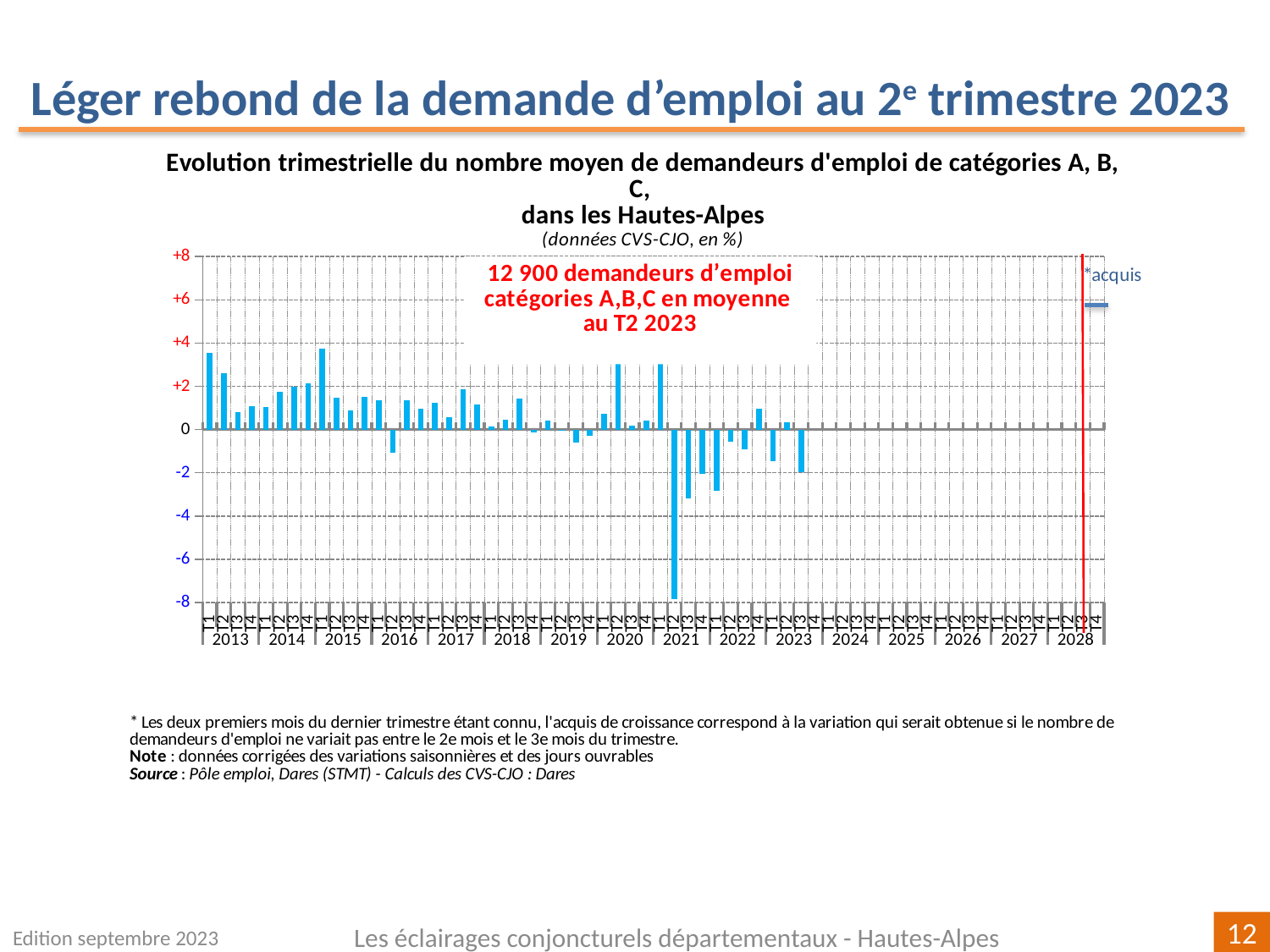
How many year labels appear along the x axis of the chart? 16 Is the value for T2 2020 greater or less than +2? greater Which is lower, the value for T2 2021 or the value for T3 2021? T2 2021 In which département does the chart measure the evolution of demandeurs d'emploi? Hautes-Alpes Which is higher, the value for T1 2013 or the value for T2 2013? T1 2013 Is the value for T2 2021 greater or less than -6? less Is the value for T3 2021 greater or less than -2? less What kind of chart is shown on the slide? Bar chart Which quarter has the lowest value on the chart? T2 2021 According to the text box on the chart, how many demandeurs d'emploi catégories A,B,C were there on average in T2 2023? 12 900